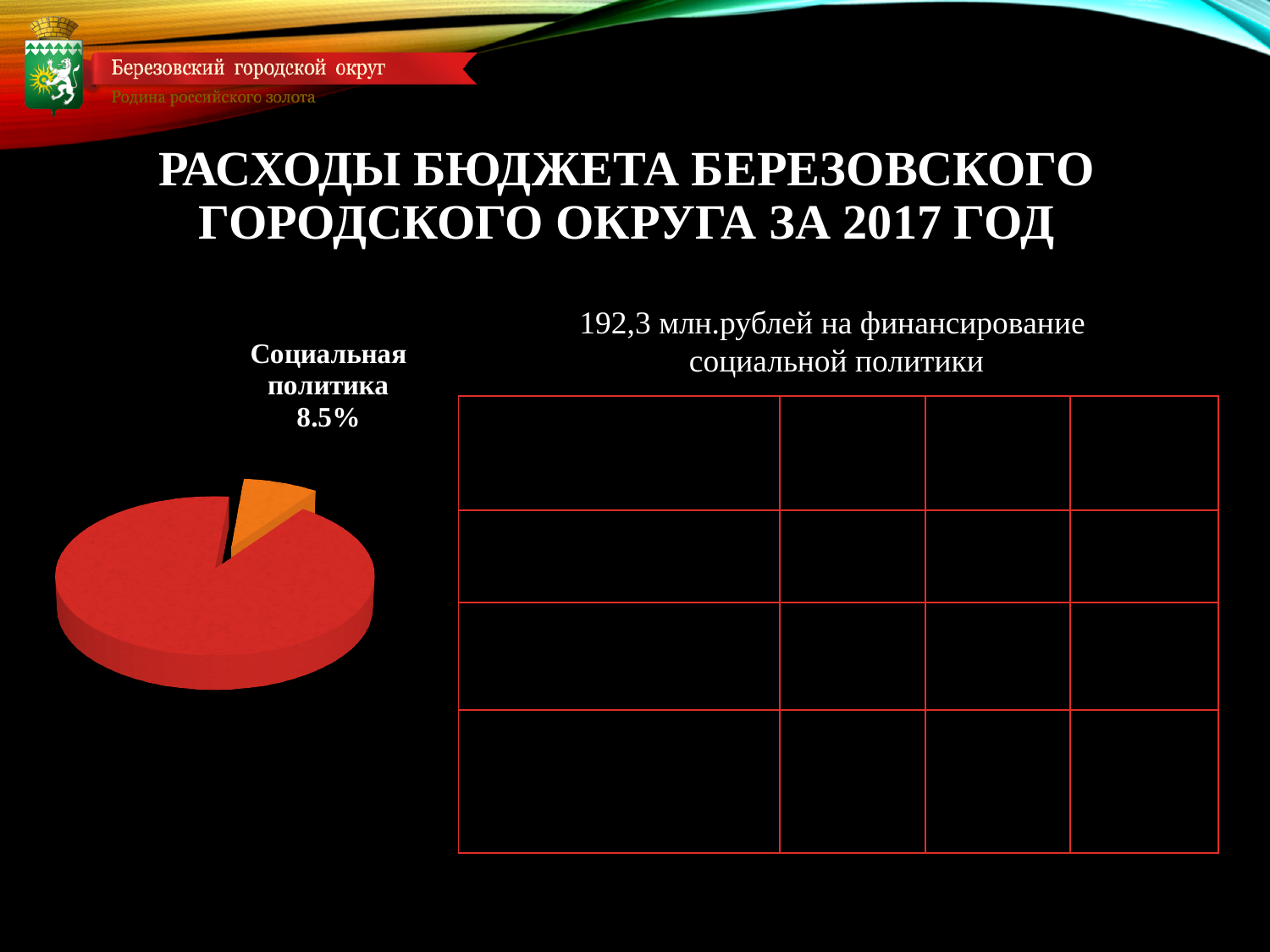
What kind of chart is shown on the slide? pie chart Is the slice labelled Социальная политика pulled out from the rest of the pie? yes Is the share for Социальная политика greater or less than 10%? less What share of the pie does the slice labelled Социальная политика represent? 8.5% Which slice of the pie chart is the smallest? Социальная политика How many slices does the pie chart have? 2 What colour is the slice labelled Социальная политика in the pie chart? orange Which slice is larger, the one labelled Социальная политика or the unlabelled red slice? the unlabelled red slice